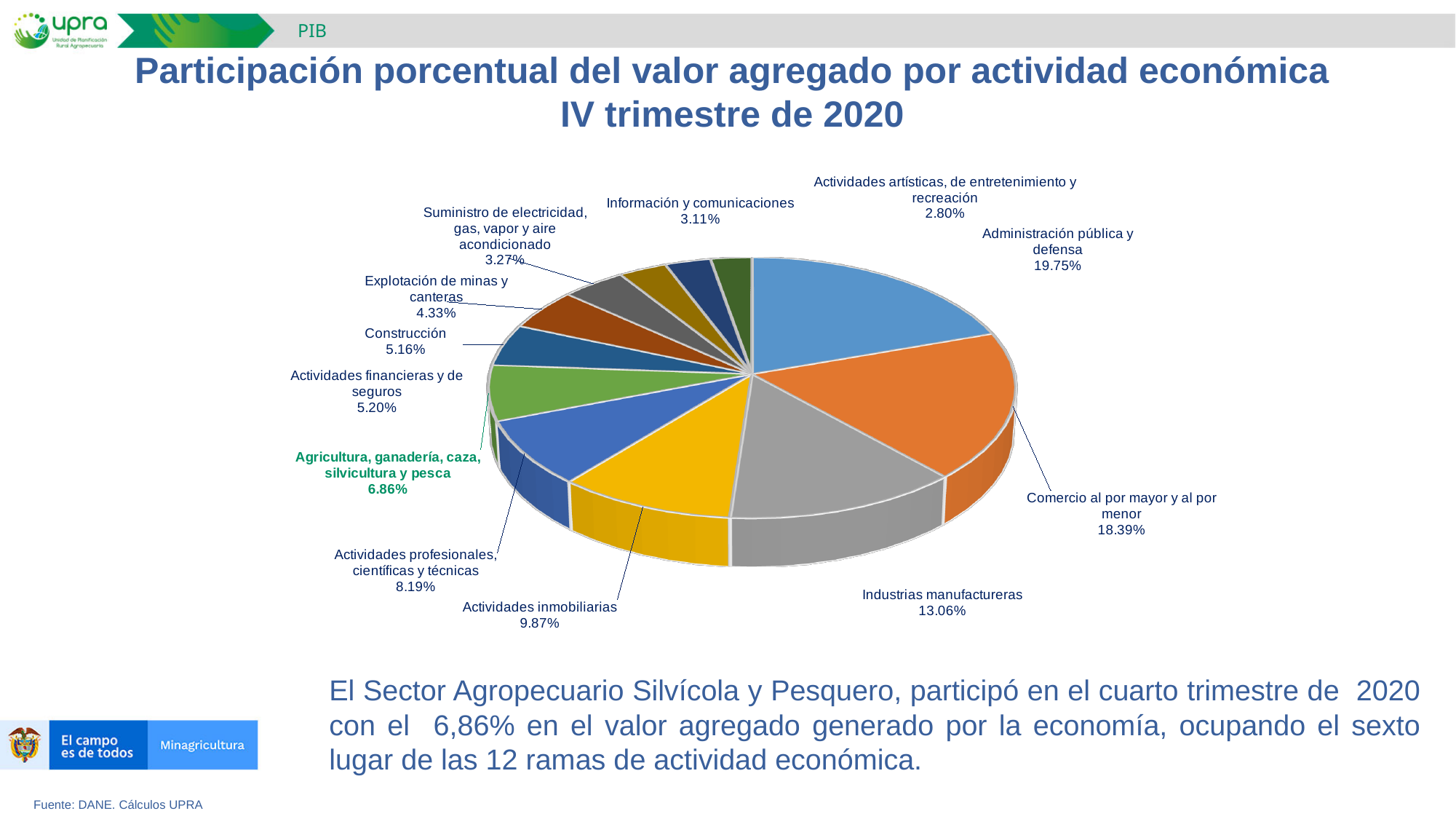
Which economic activity has the smallest share in the pie chart? Actividades artísticas, de entretenimiento y recreación Which economic activity has the largest share in the pie chart? Administración pública y defensa What is the value shown for Industrias manufactureras? 13.06% Which has a larger share: Actividades inmobiliarias or Actividades profesionales, científicas y técnicas? Actividades inmobiliarias What kind of chart is shown on the slide? Pie chart What is the difference in percentage points between Administración pública y defensa and Comercio al por mayor y al por menor? 1.36 What is the difference in percentage points between Construcción and Información y comunicaciones? 2.05 What is the share of Administración pública y defensa in the pie chart? 19.75% What is the value shown for Explotación de minas y canteras? 4.33% How many economic activities (slices) are shown in the pie chart? 12 What is the title of the chart on the slide? Participación porcentual del valor agregado por actividad económica IV trimestre de 2020 What percentage does Agricultura, ganadería, caza, silvicultura y pesca represent in the pie chart? 6.86%